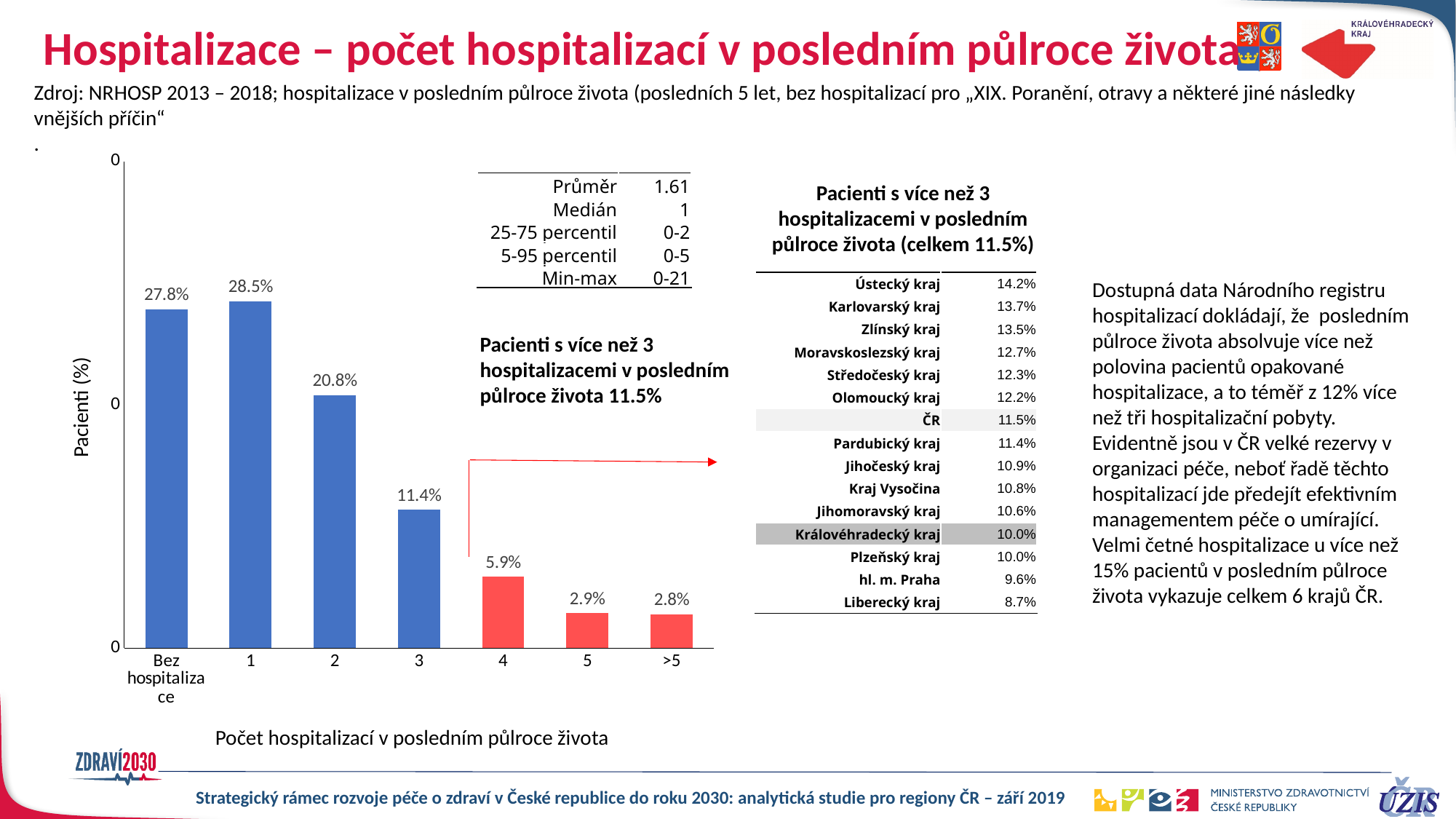
What is the value shown for patients with exactly 1 hospitalisation? 28.5% How many categories are shown on the x axis of the bar chart? 7 What percentage of patients had no hospitalisation ("Bez hospitalizace") in the last half year of life? 27.8% What is the x-axis title of the bar chart? Počet hospitalizací v posledním půlroce života Do the values rise or fall along the x axis from category "1" to category ">5"? Fall Which category has the highest value in the bar chart? 1 What is the difference between the values for category "2" and category "3"? 9.4% Which category has the lowest value in the bar chart? >5 Which is larger: the value for "Bez hospitalizace" or the value for "2"? Bez hospitalizace What is the value shown for the category "3" hospitalisations? 11.4% What is the value shown for the category ">5" hospitalisations? 2.8% What kind of chart is shown on the slide? Bar chart